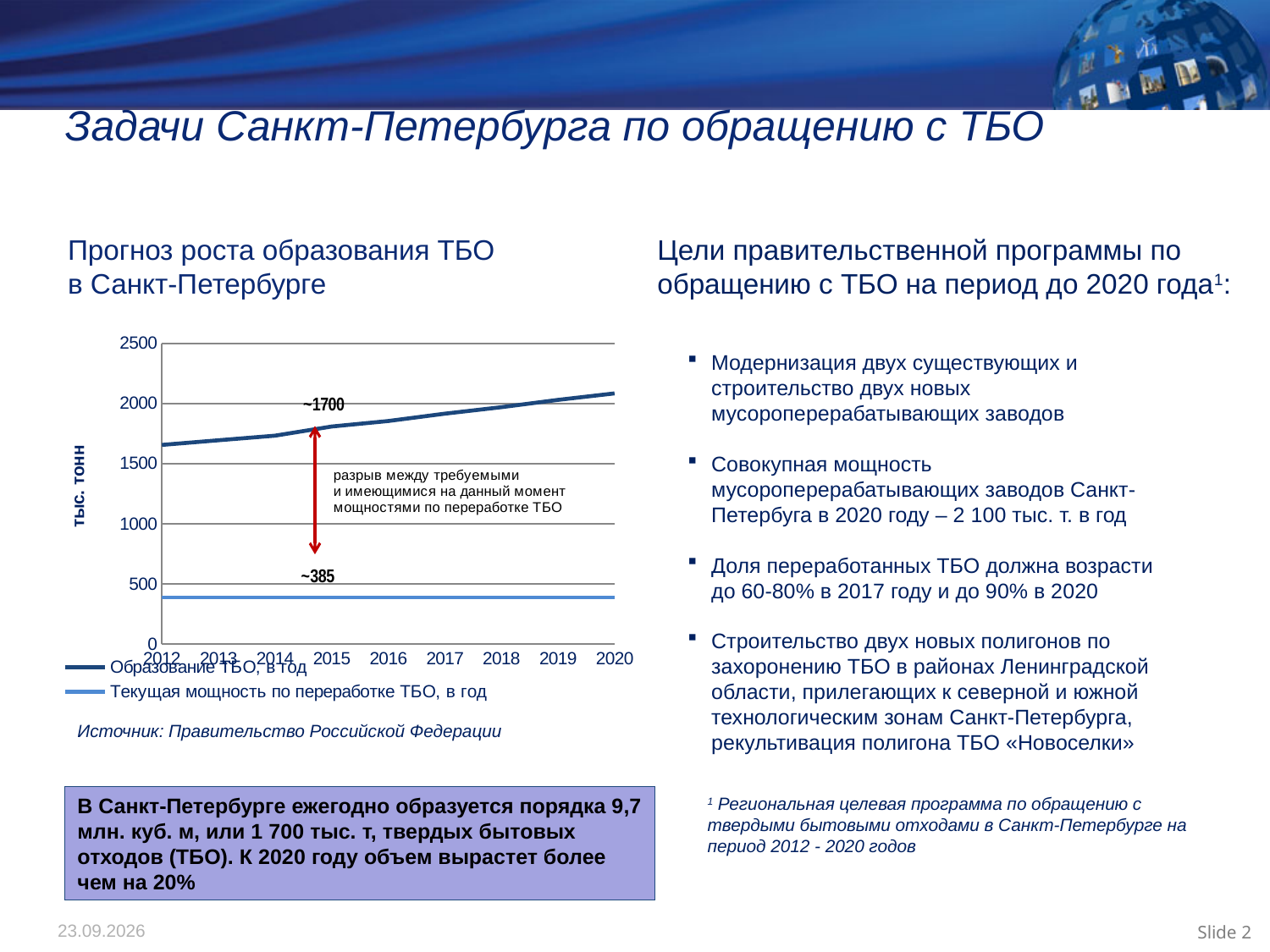
Does the series 'Текущая мощность по переработке ТБО, в год' rise, fall or stay flat from 2012 to 2020? stay flat Is the value for 'Образование ТБО, в год' in 2012 greater or less than 2000? less Is the value for 'Текущая мощность по переработке ТБО, в год' greater or less than 500? less Does the series 'Образование ТБО, в год' rise or fall from 2012 to 2020? rise How many years are shown along the x axis of the chart? 9 How many series does the chart legend list? 2 What is the label on the vertical axis of the chart? тыс. тонн What kind of chart is shown on the slide? line chart Is the value for 'Образование ТБО, в год' in 2015 greater or less than 1500? greater What is the first year shown on the x axis of the chart? 2012 In 2020, which series has the higher value: 'Образование ТБО, в год' or 'Текущая мощность по переработке ТБО, в год'? Образование ТБО, в год